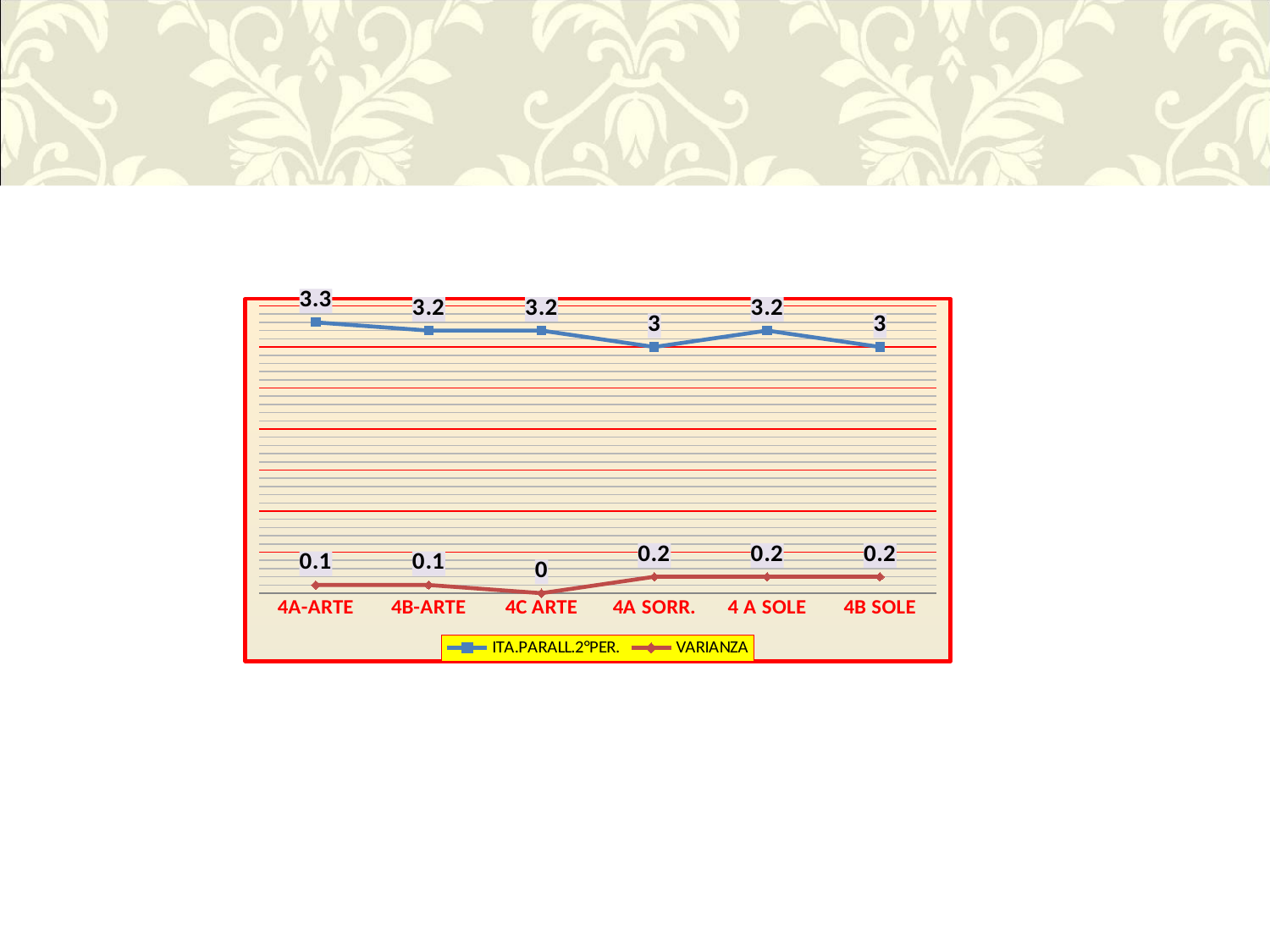
What is the value of VARIANZA for 4C ARTE? 0 Which category has the highest value for ITA.PARALL.2°PER.? 4A-ARTE Which category has the lowest value for VARIANZA? 4C ARTE What is the value of ITA.PARALL.2°PER. for 4A SORR.? 3 Which series is drawn in blue in the legend? ITA.PARALL.2°PER. What is the value of VARIANZA for 4B SOLE? 0.2 What kind of chart is shown on the slide? line chart What is the difference between the ITA.PARALL.2°PER. values for 4A-ARTE and 4B SOLE? 0.3 How many series does the legend list? 2 How many categories are shown on the x axis? 6 Which is larger, the VARIANZA value for 4A-ARTE or for 4A SORR.? 4A SORR. What is the value of ITA.PARALL.2°PER. for 4A-ARTE? 3.3